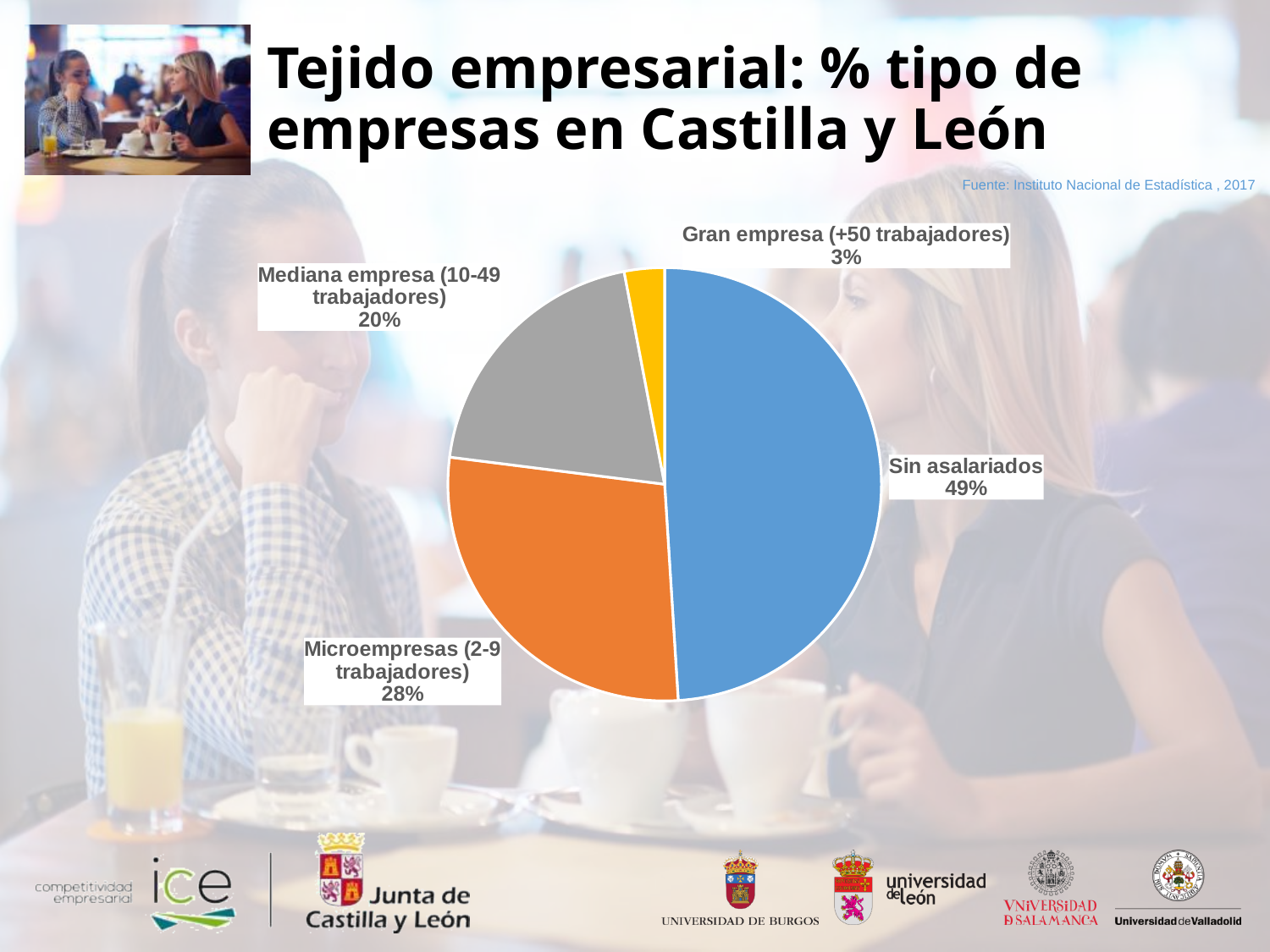
What percentage of companies in Castilla y León are 'Sin asalariados'? 49% How many categories are shown in the pie chart? 4 What share of the pie corresponds to 'Microempresas (2-9 trabajadores)'? 28% What colour is the slice for 'Sin asalariados'? blue Which category has the smallest slice of the pie? Gran empresa (+50 trabajadores) Which is larger: the share for 'Mediana empresa (10-49 trabajadores)' or for 'Microempresas (2-9 trabajadores)'? Microempresas (2-9 trabajadores) What is the difference in percentage points between 'Sin asalariados' and 'Microempresas (2-9 trabajadores)'? 21 percentage points What percentage is shown for 'Mediana empresa (10-49 trabajadores)'? 20% Which category has the largest slice of the pie? Sin asalariados What is the combined share of 'Mediana empresa (10-49 trabajadores)' and 'Gran empresa (+50 trabajadores)'? 23% What percentage is shown for 'Gran empresa (+50 trabajadores)'? 3% What type of chart is shown on the slide? pie chart